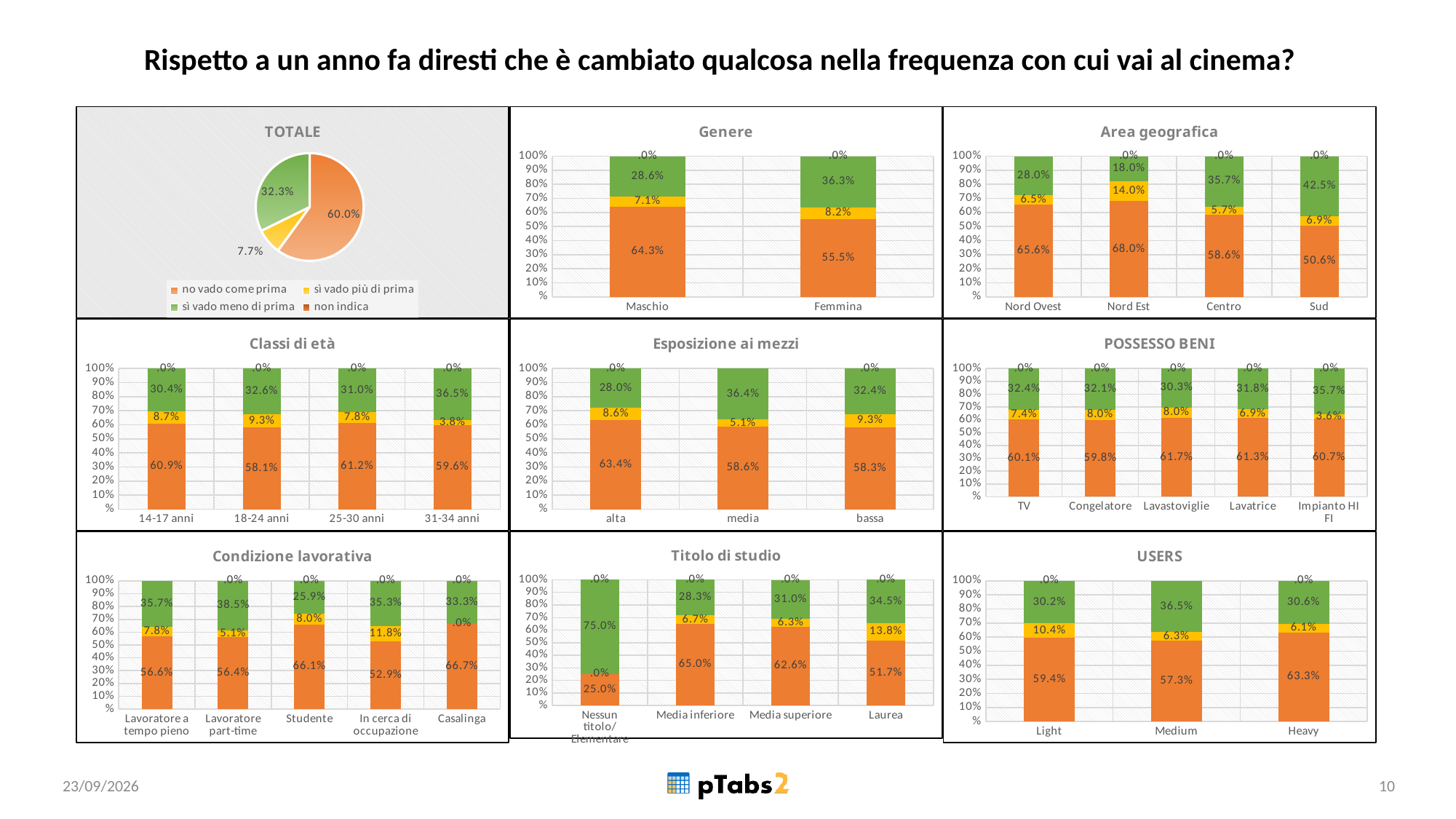
In the Esposizione ai mezzi chart, what is the value of "sì vado più di prima" for media? 5.1% In the Genere chart, what is the value of "sì vado meno di prima" for Femmina? 36.3% In the USERS chart, which has the larger value for "no vado come prima", Light or Heavy? Heavy In the Area geografica chart, which area has the highest value for "no vado come prima"? Nord Est How many categories are shown in the POSSESSO BENI chart? 5 How many age categories are shown in the Classi di età chart? 4 In the Condizione lavorativa chart, which category has the lowest value for "no vado come prima"? In cerca di occupazione In the TOTALE chart, what share of respondents answered "no vado come prima"? 60.0% What kind of chart is the Genere chart? bar chart What kind of chart is the TOTALE chart? pie chart How many series does the legend in the TOTALE chart list? 4 In the Area geografica chart, what is the difference between Nord Ovest and Sud for "no vado come prima"? 15.0%